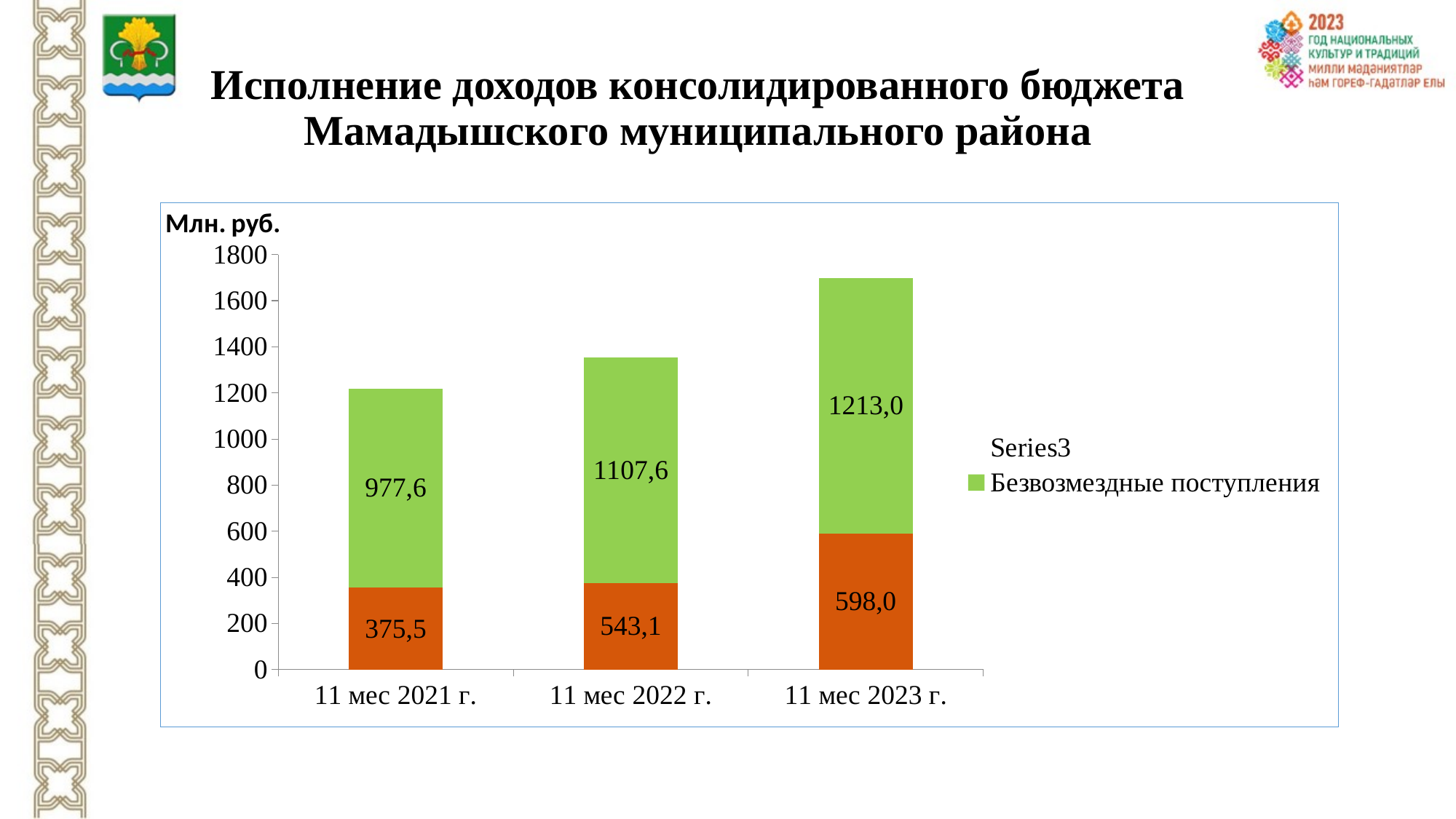
For 11 мес 2022 г., which is larger: the Безвозмездные поступления segment or the orange segment? Безвозмездные поступления What value is printed on the orange segment of the bar for 11 мес 2023 г.? 598,0 What is the value of Безвозмездные поступления for 11 мес 2022 г.? 1107,6 What is the value of Безвозмездные поступления for 11 мес 2021 г.? 977,6 How many entries does the legend list? 2 What is the difference between the orange segment values for 11 мес 2022 г. and 11 мес 2021 г.? 167,6 Which period has the lowest value on the orange segment? 11 мес 2021 г. What value is printed on the orange segment of the bar for 11 мес 2021 г.? 375,5 Which period has the highest value for Безвозмездные поступления? 11 мес 2023 г. What kind of chart is shown on the slide? Stacked bar chart By how much does Безвозмездные поступления for 11 мес 2023 г. exceed that for 11 мес 2021 г.? 235,4 How many periods are shown on the x axis? 3